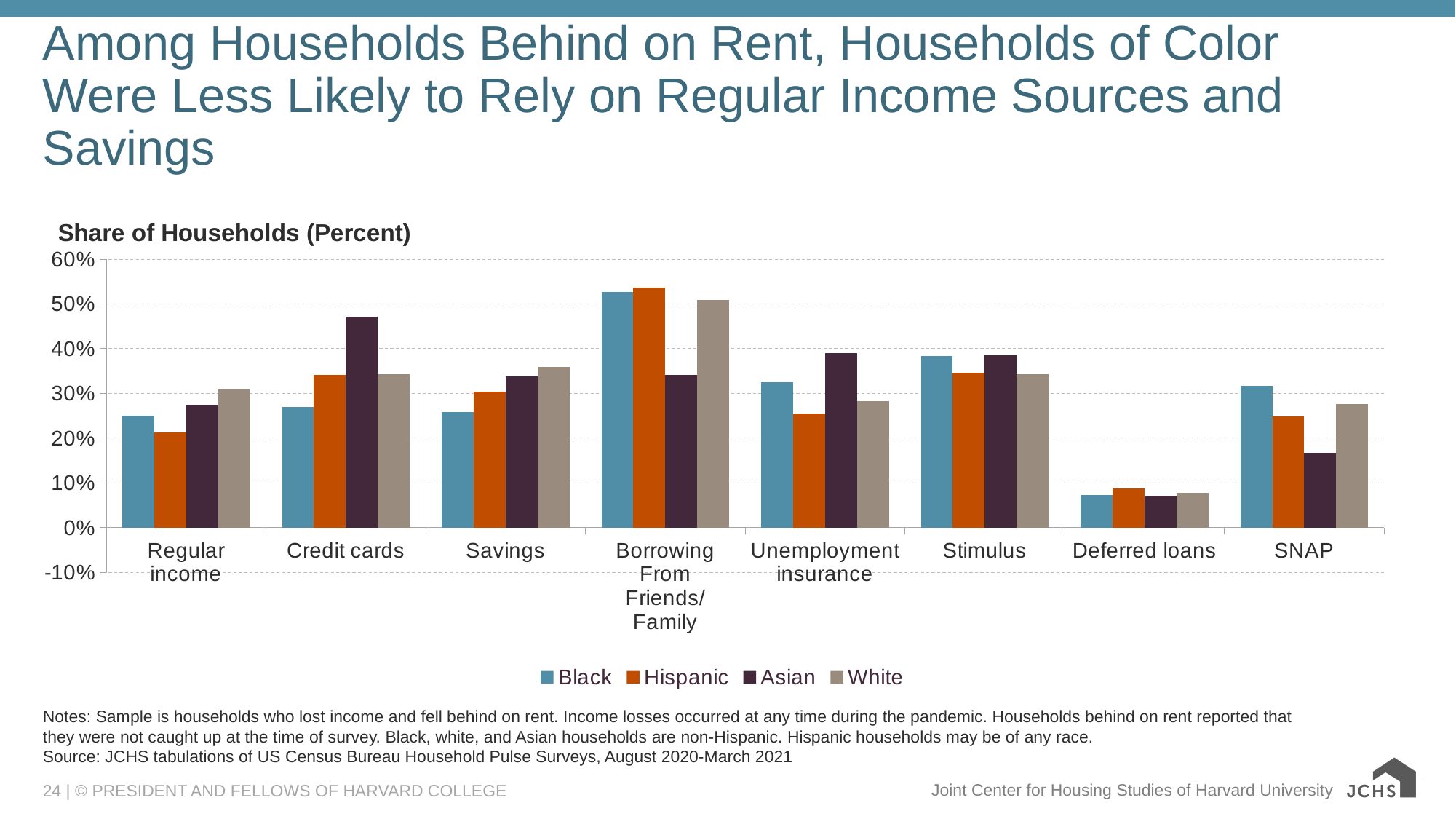
How many series does the legend list? 4 Under Unemployment insurance, which group has the highest share? Asian Is the value for Asian households under SNAP greater or less than 20%? less For White households, which category has the lowest share? Deferred loans What kind of chart is shown on the slide? bar chart Is the value for Hispanic households under Regular income greater or less than 25%? less Is the value for Asian households under Credit cards greater or less than 40%? greater Under Credit cards, which is larger: the value for Asian households or for Hispanic households? Asian How many income-source categories are shown on the x axis? 8 For Black households, which category has the highest share? Borrowing From Friends/Family What is the axis title shown above the chart? Share of Households (Percent)